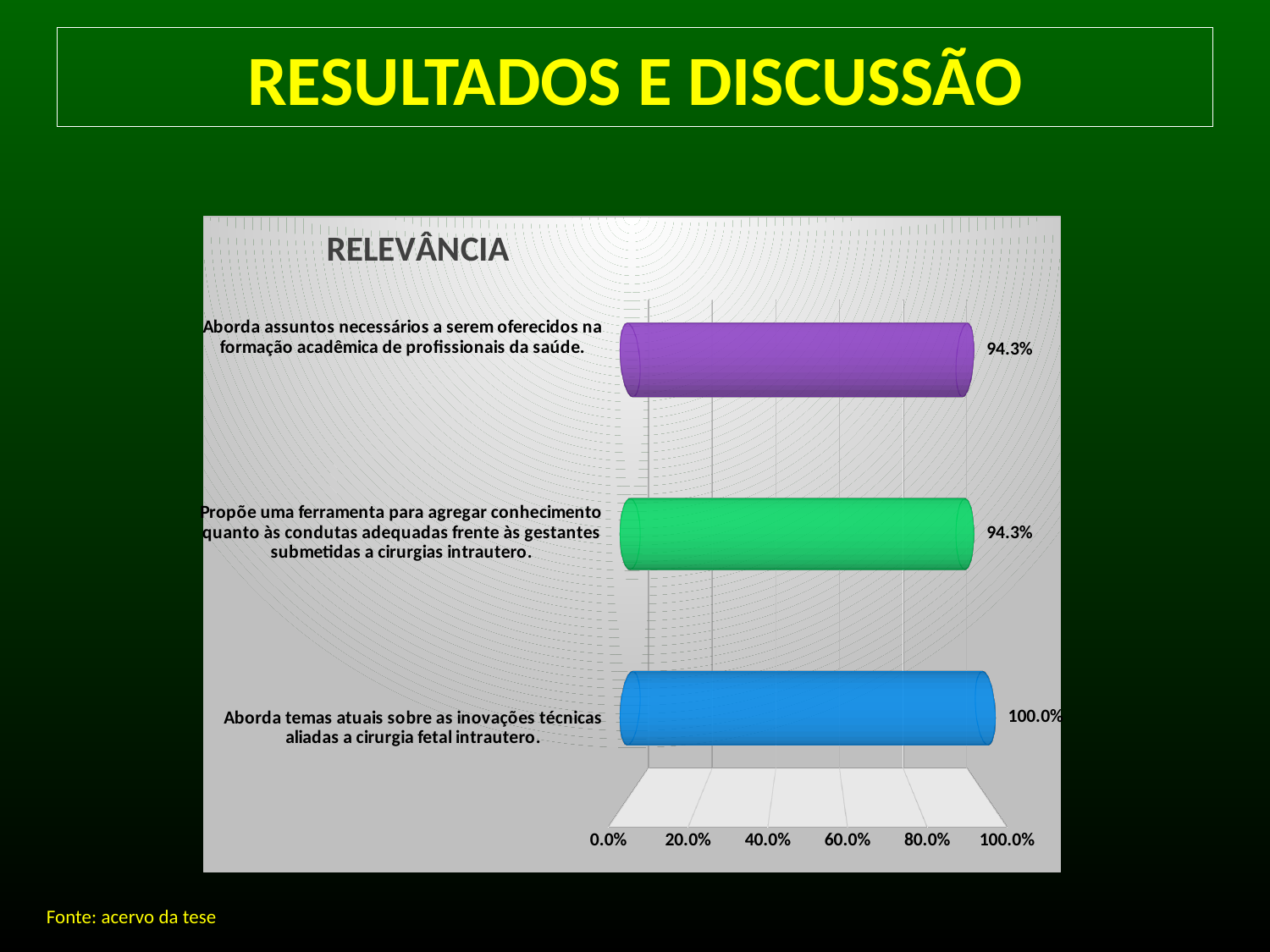
What is the difference between the value for "Aborda temas atuais sobre as inovações técnicas aliadas a cirurgia fetal intrautero." and the value for "Aborda assuntos necessários a serem oferecidos na formação acadêmica de profissionais da saúde."? 5.7% What colour is the bar for "Aborda temas atuais sobre as inovações técnicas aliadas a cirurgia fetal intrautero."? blue What is the title of the chart? RELEVÂNCIA What is the value for "Aborda assuntos necessários a serem oferecidos na formação acadêmica de profissionais da saúde."? 94.3% What is the value for "Aborda temas atuais sobre as inovações técnicas aliadas a cirurgia fetal intrautero."? 100.0% What is the highest value labelled on the x axis? 100.0% Which is larger: the value for "Aborda temas atuais sobre as inovações técnicas aliadas a cirurgia fetal intrautero." or the value for "Propõe uma ferramenta para agregar conhecimento quanto às condutas adequadas frente às gestantes submetidas a cirurgias intrautero."? Aborda temas atuais sobre as inovações técnicas aliadas a cirurgia fetal intrautero. Is the value for "Aborda assuntos necessários a serem oferecidos na formação acadêmica de profissionais da saúde." greater or less than 80.0%? greater What kind of chart is shown on the slide? bar chart Which category has the highest value? Aborda temas atuais sobre as inovações técnicas aliadas a cirurgia fetal intrautero. What is the value for "Propõe uma ferramenta para agregar conhecimento quanto às condutas adequadas frente às gestantes submetidas a cirurgias intrautero."? 94.3% How many categories are shown in the chart? 3